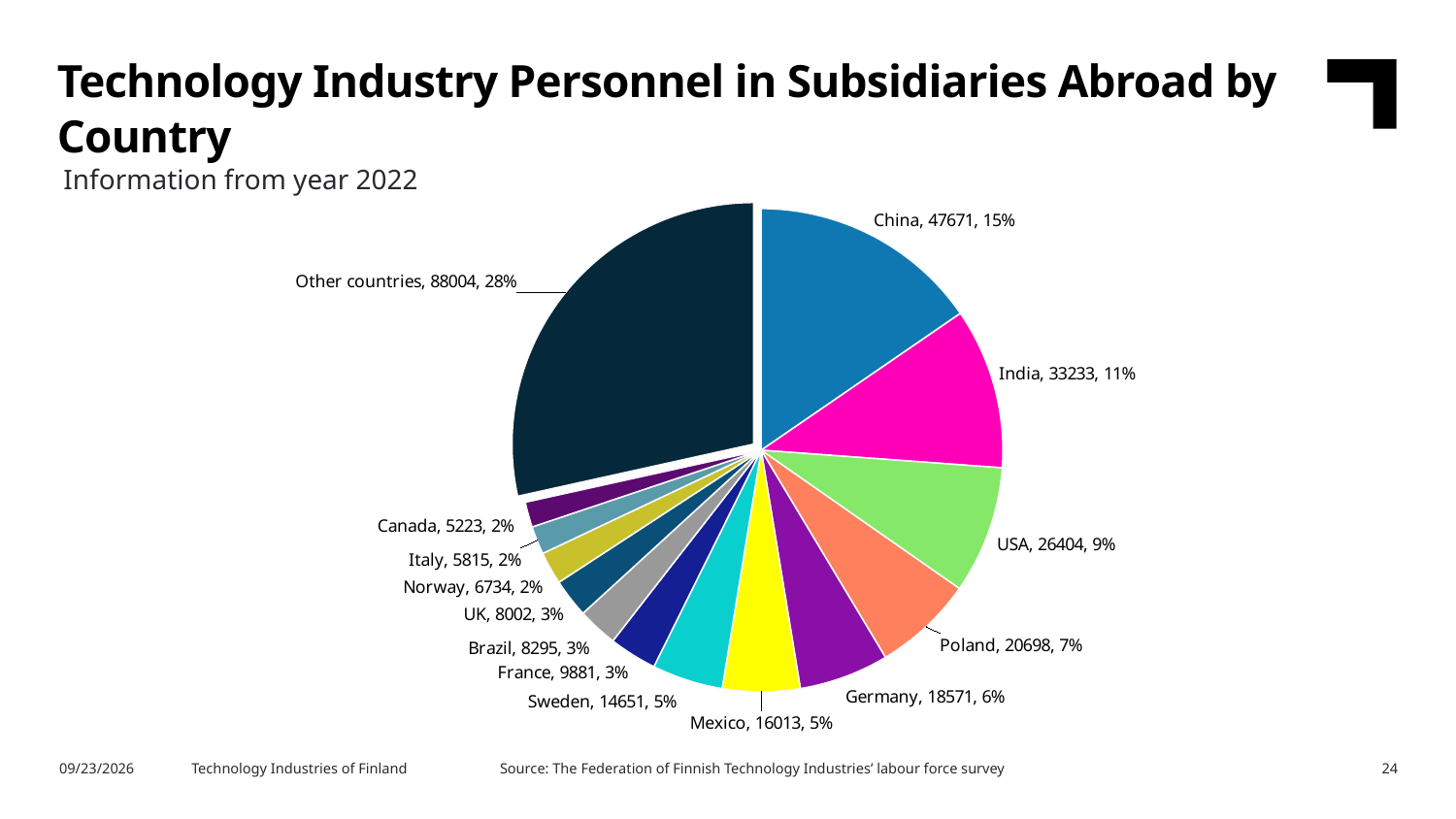
Which slice is the largest? Other countries What kind of chart is shown on the slide? Pie chart Which country has the smallest slice? Canada Which is larger, the value for Germany or the value for Mexico? Germany What is the value for China? 47671 What is the value for Poland? 20698 What share of the pie does Other countries represent? 28% What is the difference between the values for China and India? 14438 What is the title of the chart? Technology Industry Personnel in Subsidiaries Abroad by Country What share of the pie does India represent? 11% What is the value for Canada? 5223 How many slices does the pie chart have? 14